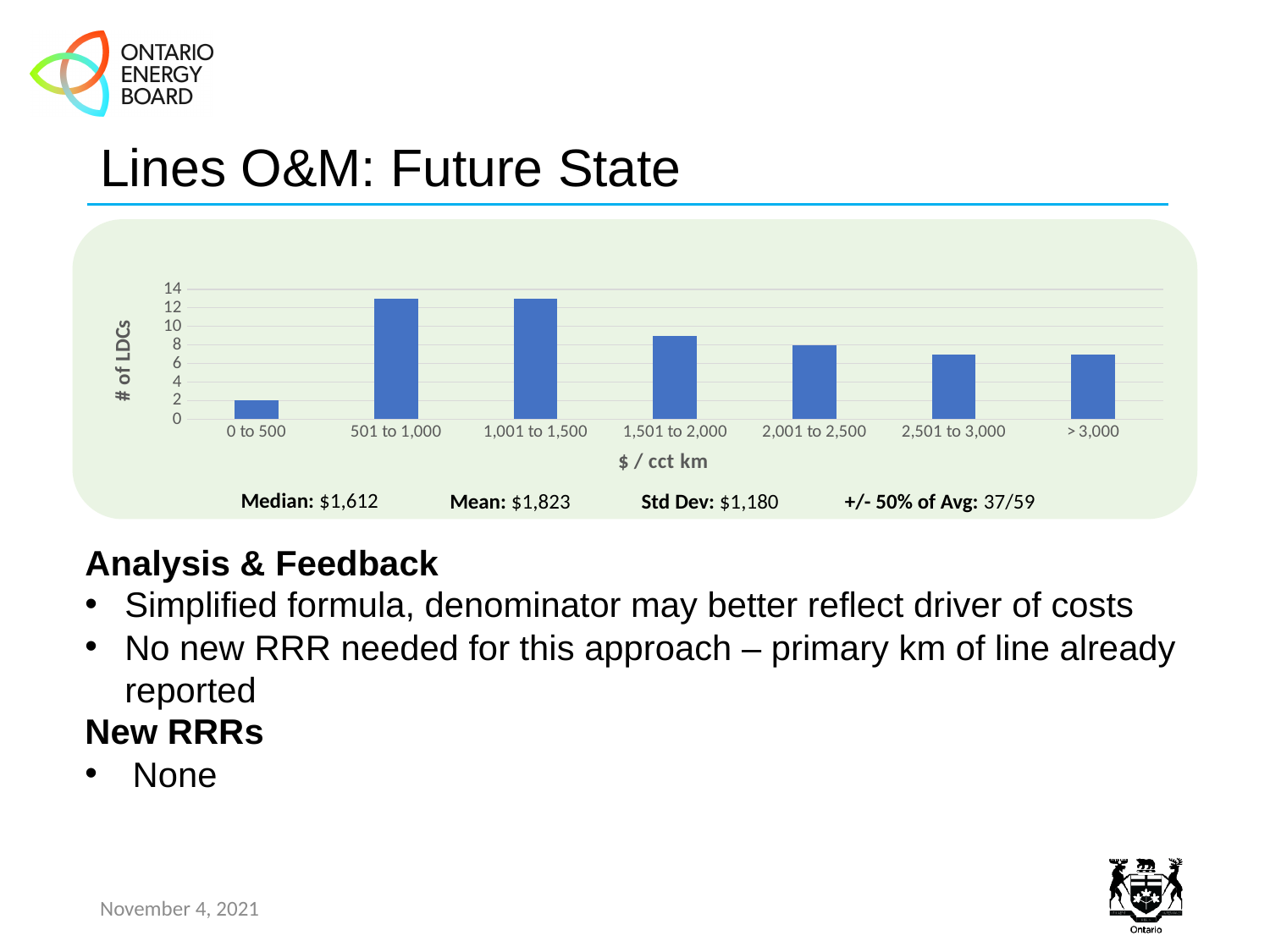
Is the number of LDCs for > 3,000 greater or less than 8? less Is the number of LDCs for 1,001 to 1,500 greater or less than 12? greater Which has more LDCs: 501 to 1,000 or 1,501 to 2,000? 501 to 1,000 Is the number of LDCs for 501 to 1,000 greater or less than 10? greater What is the label of the chart's y axis? # of LDCs From the 1,001 to 1,500 category onward, do the bar values generally rise or fall along the x axis? fall Which $ / cct km category has the lowest number of LDCs? 0 to 500 Which has more LDCs: 2,001 to 2,500 or 0 to 500? 2,001 to 2,500 What kind of chart is shown on the slide? bar chart How many $ / cct km categories are shown on the x axis of the chart? 7